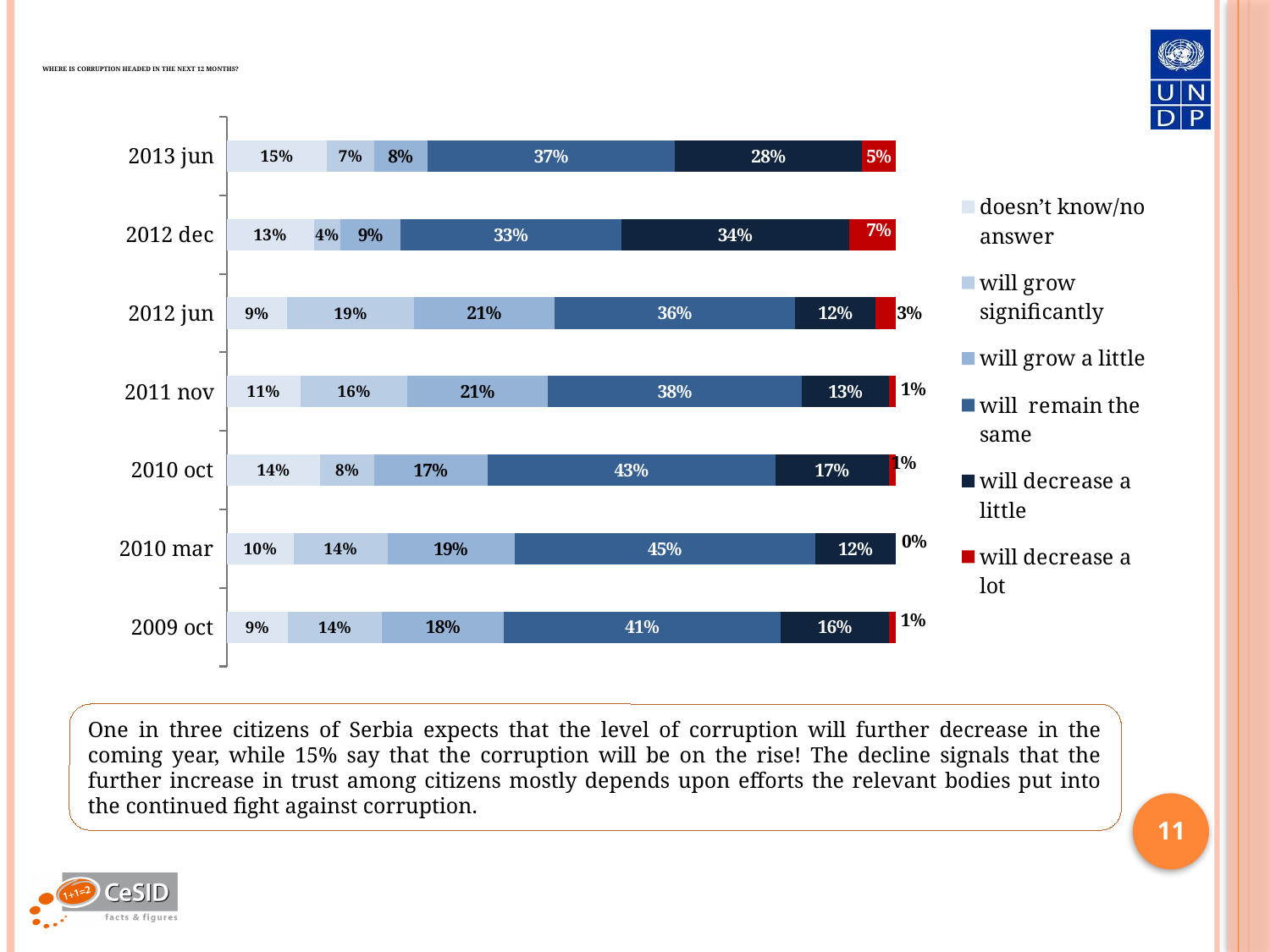
In which period is the 'will decrease a lot' share the lowest? 2010 mar How many time periods are shown on the chart? 7 How many series does the legend list? 6 What percentage of respondents in 2013 jun said corruption will remain the same? 37% What is the value for 'will grow significantly' in 2012 jun? 19% How many percentage points higher is 'will decrease a little' in 2013 jun than in 2012 jun? 16 percentage points Which colour represents 'will decrease a lot' in the legend? Red What is the value for 'will decrease a lot' in 2012 dec? 7% What kind of chart is shown on the slide? Stacked bar chart Which period has a larger 'will decrease a little' share, 2012 dec or 2013 jun? 2012 dec What is the total of the 2013 jun bar? 100% In which period is the 'will remain the same' share the highest? 2010 mar